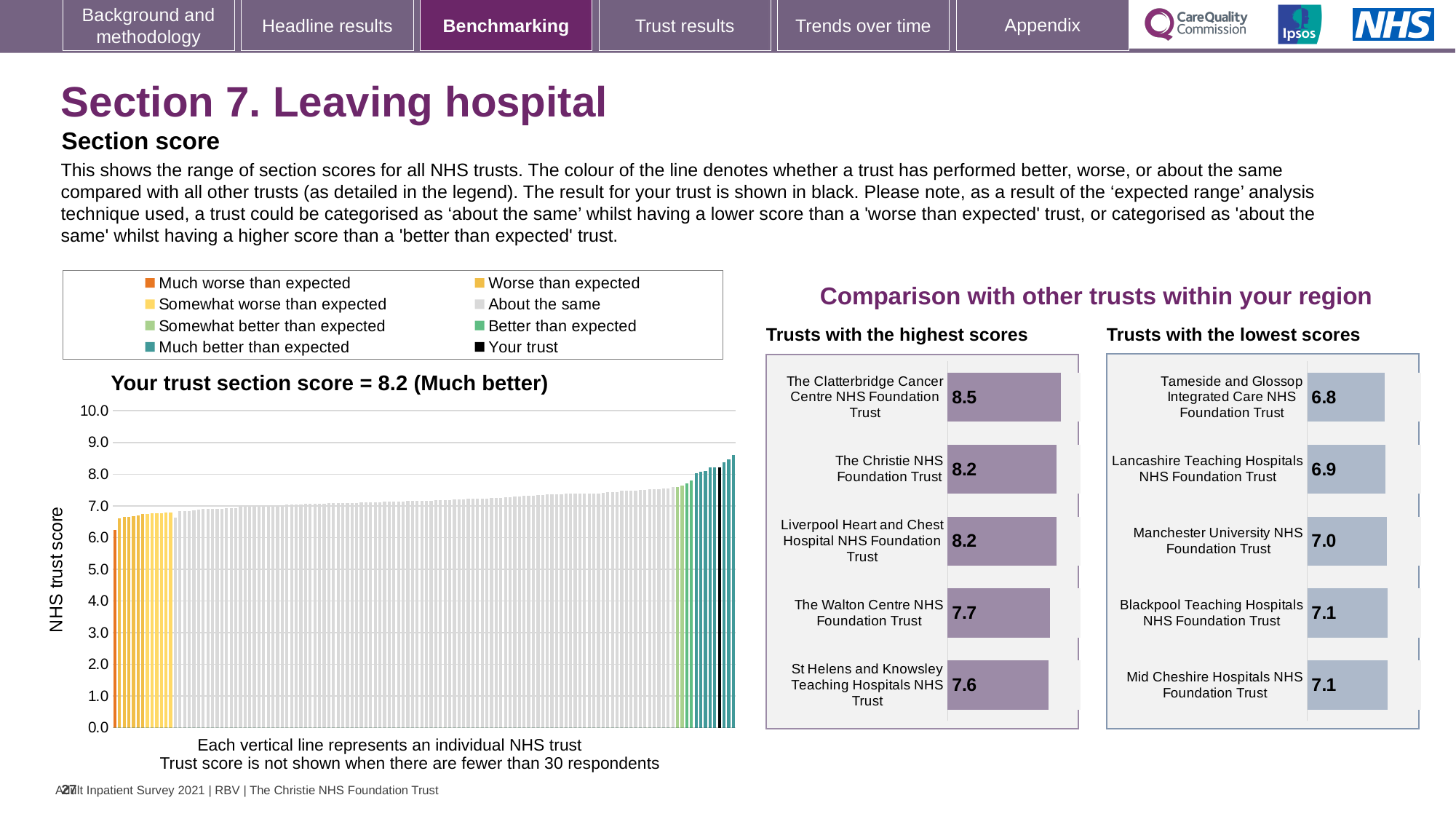
In the 'Trusts with the highest scores' chart, which trust has the highest score? The Clatterbridge Cancer Centre NHS Foundation Trust In the 'Trusts with the lowest scores' chart, what is the score for Manchester University NHS Foundation Trust? 7.0 In the 'Trusts with the highest scores' chart, what is the difference between the scores of The Clatterbridge Cancer Centre NHS Foundation Trust and St Helens and Knowsley Teaching Hospitals NHS Trust? 0.9 In the 'Your trust section score = 8.2 (Much better)' chart, do the bar values rise or fall from left to right? Rise In the 'Trusts with the highest scores' chart, what is the score for The Walton Centre NHS Foundation Trust? 7.7 In the 'Trusts with the lowest scores' chart, which has the larger score: Lancashire Teaching Hospitals NHS Foundation Trust or Blackpool Teaching Hospitals NHS Foundation Trust? Blackpool Teaching Hospitals NHS Foundation Trust What kind of chart is the 'Your trust section score = 8.2 (Much better)' chart? Bar chart In the 'Trusts with the highest scores' chart, what is the score for The Clatterbridge Cancer Centre NHS Foundation Trust? 8.5 How many entries does the legend of the 'Your trust section score' chart list? 8 In the 'Trusts with the lowest scores' chart, which trust has the lowest score? Tameside and Glossop Integrated Care NHS Foundation Trust In the 'Trusts with the lowest scores' chart, what is the score for Tameside and Glossop Integrated Care NHS Foundation Trust? 6.8 How many trusts are shown in the 'Trusts with the highest scores' chart? 5